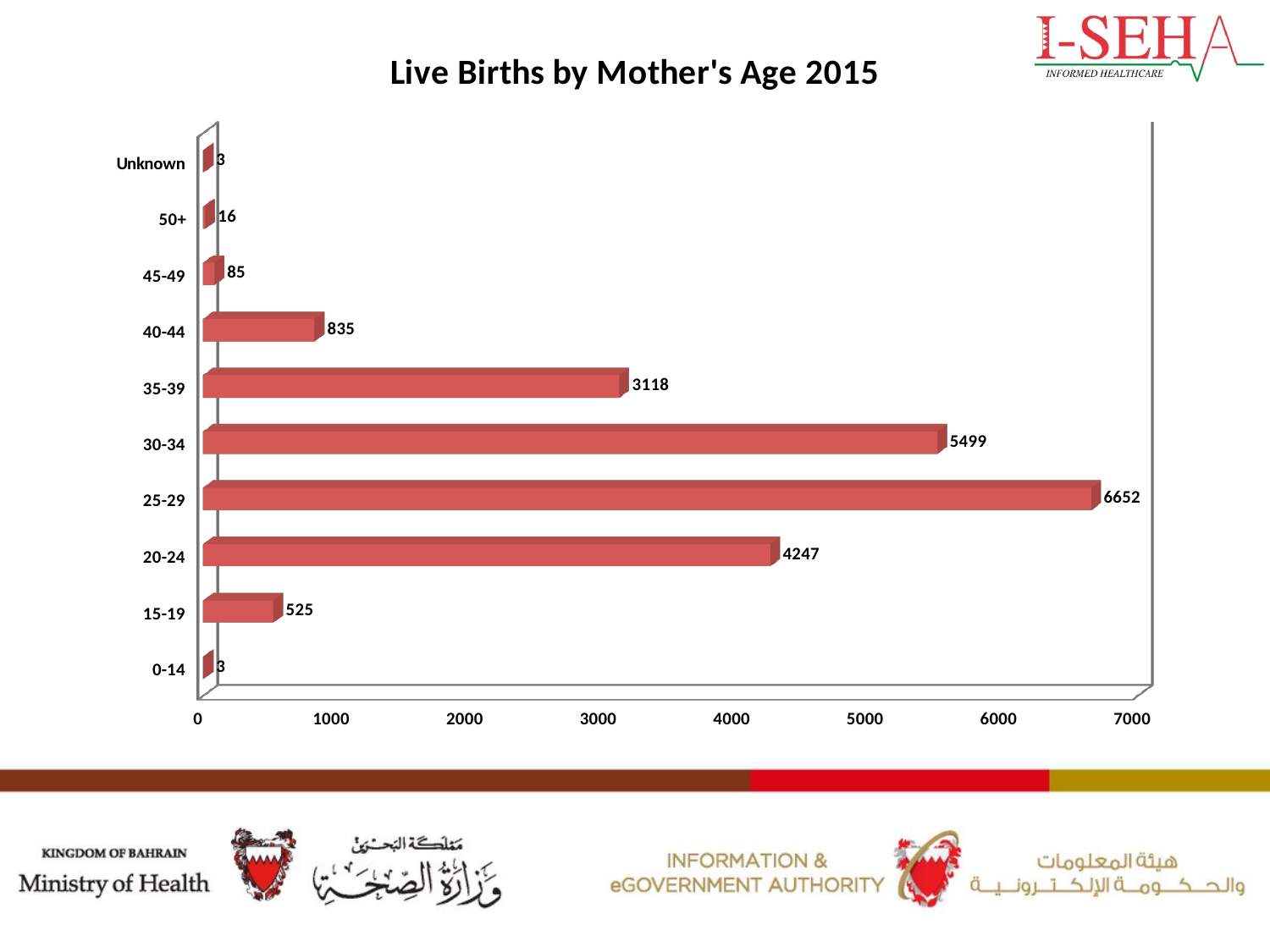
What is the number of live births for mothers aged 35-39? 3118 What kind of chart is shown on the slide? bar chart Which mother's age group has the highest number of live births? 25-29 Is the value for the 40-44 age group greater or less than 1000? less What is the title of the chart? Live Births by Mother's Age 2015 What is the number of live births for mothers aged 15-19? 525 What is the number of live births for mothers aged 50+? 16 What is the number of live births for mothers aged 25-29? 6652 How many age categories are shown on the chart? 10 What is the difference in live births between the 25-29 and 30-34 age groups? 1153 What is the difference in live births between the 20-24 and 35-39 age groups? 1129 Which age group has more live births, 20-24 or 30-34? 30-34